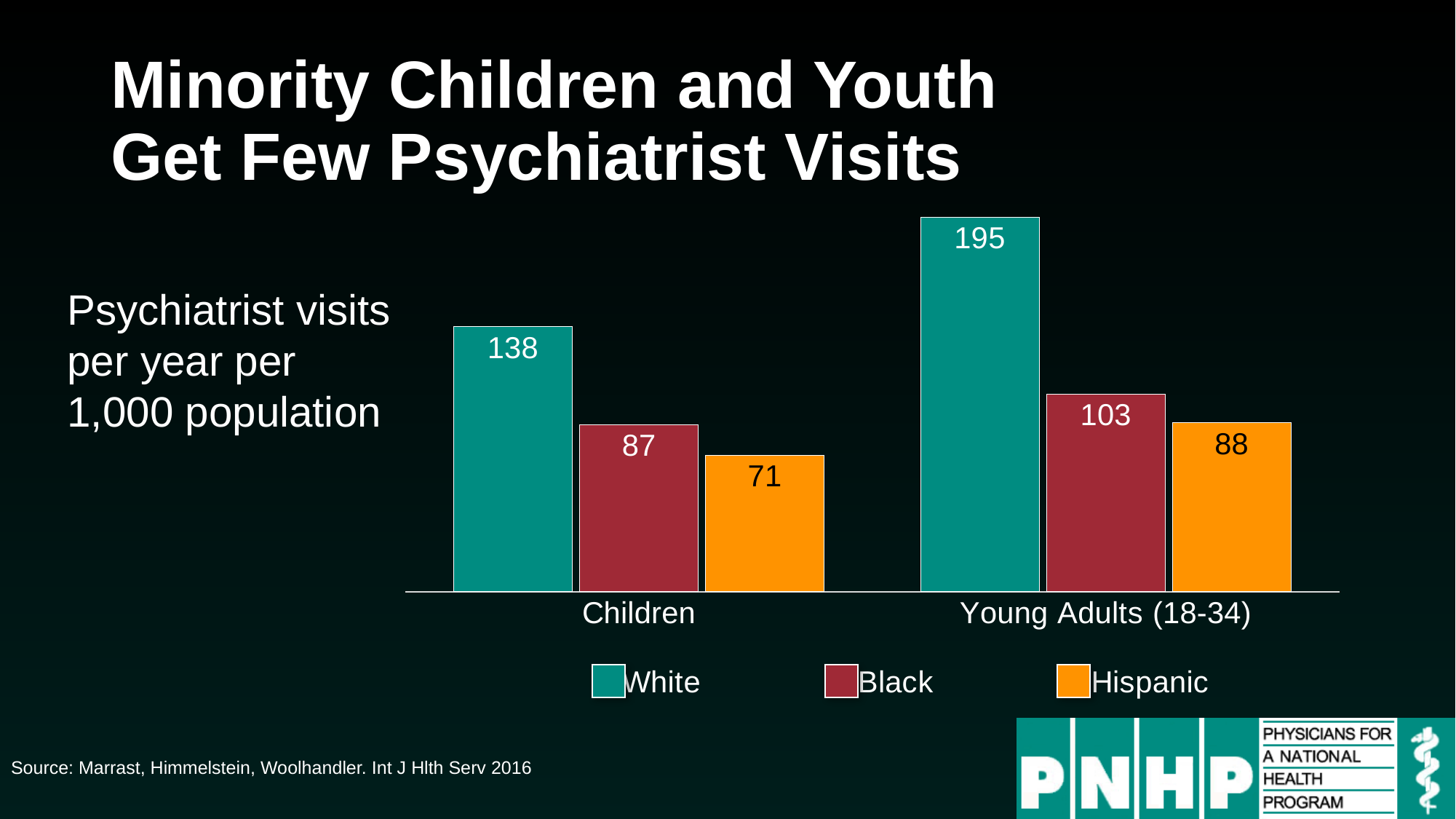
Which is larger: the Black value for Children or the Hispanic value for Young Adults (18-34)? Hispanic value for Young Adults (18-34) What is the value for Hispanic in the Young Adults (18-34) category? 88 How many series does the legend list? 3 What is the value for Black in the Children category? 87 What is the value for White in the Children category? 138 How many categories are shown on the x axis? 2 What kind of chart is shown on the slide? Bar chart What is the difference between the White values for Young Adults (18-34) and Children? 57 What is the difference between the White and Black values for Young Adults (18-34)? 92 What colour represents the Hispanic series in the chart? Orange Which series has the lowest value in the Children category? Hispanic Which series has the highest value in the Young Adults (18-34) category? White